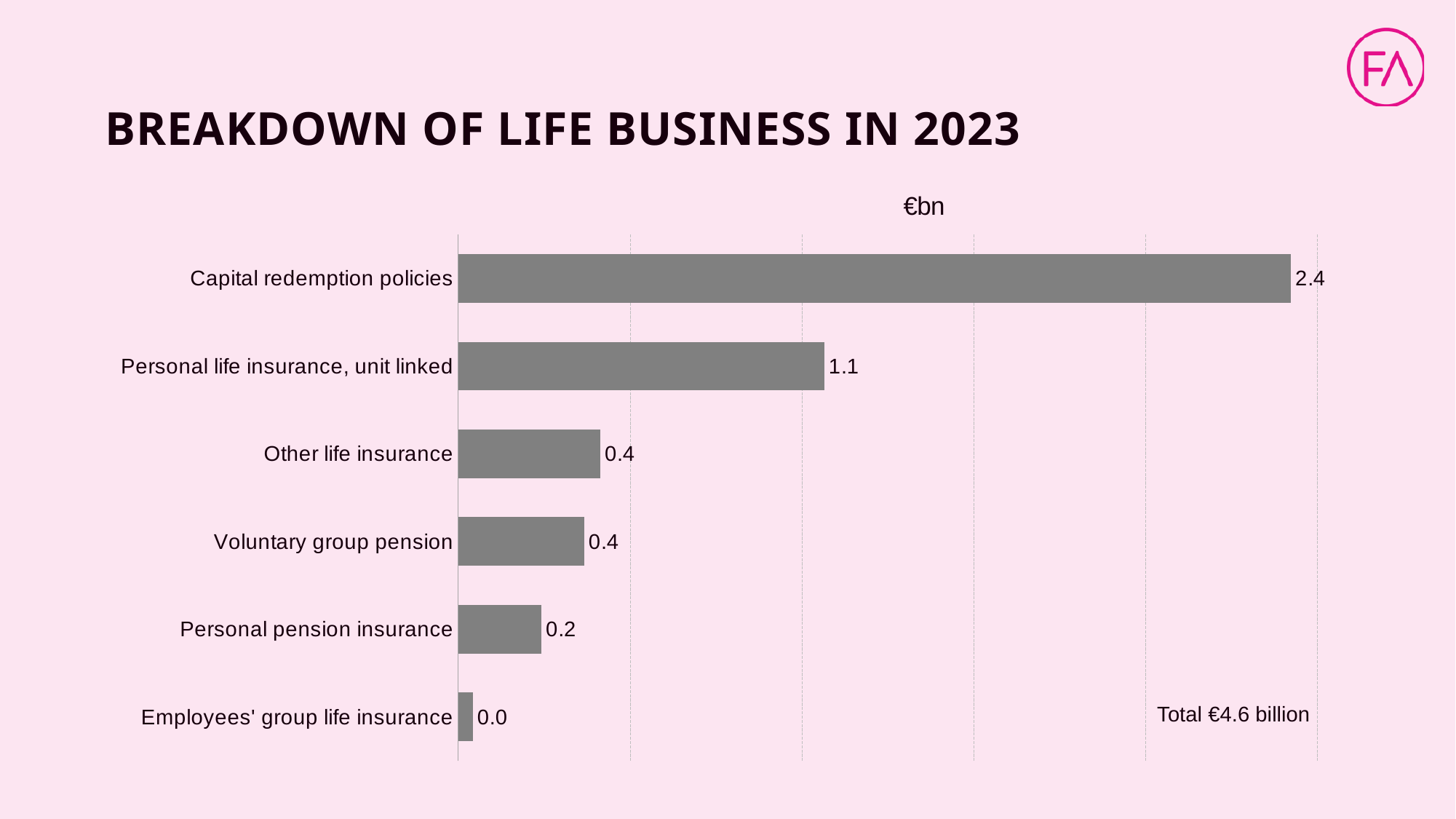
What is the value for Employees' group life insurance? 0.0 Which is larger, Personal life insurance, unit linked or Other life insurance? Personal life insurance, unit linked Which category has the lowest value? Employees' group life insurance What is the value for Personal life insurance, unit linked? 1.1 What unit is shown above the chart? €bn What is the title of the slide? BREAKDOWN OF LIFE BUSINESS IN 2023 What is the difference between Capital redemption policies and Personal life insurance, unit linked? 1.3 How many categories are shown in the chart? 6 What is the value for Personal pension insurance? 0.2 What is the value for Capital redemption policies? 2.4 Which category has the highest value? Capital redemption policies What kind of chart is shown on the slide? Bar chart